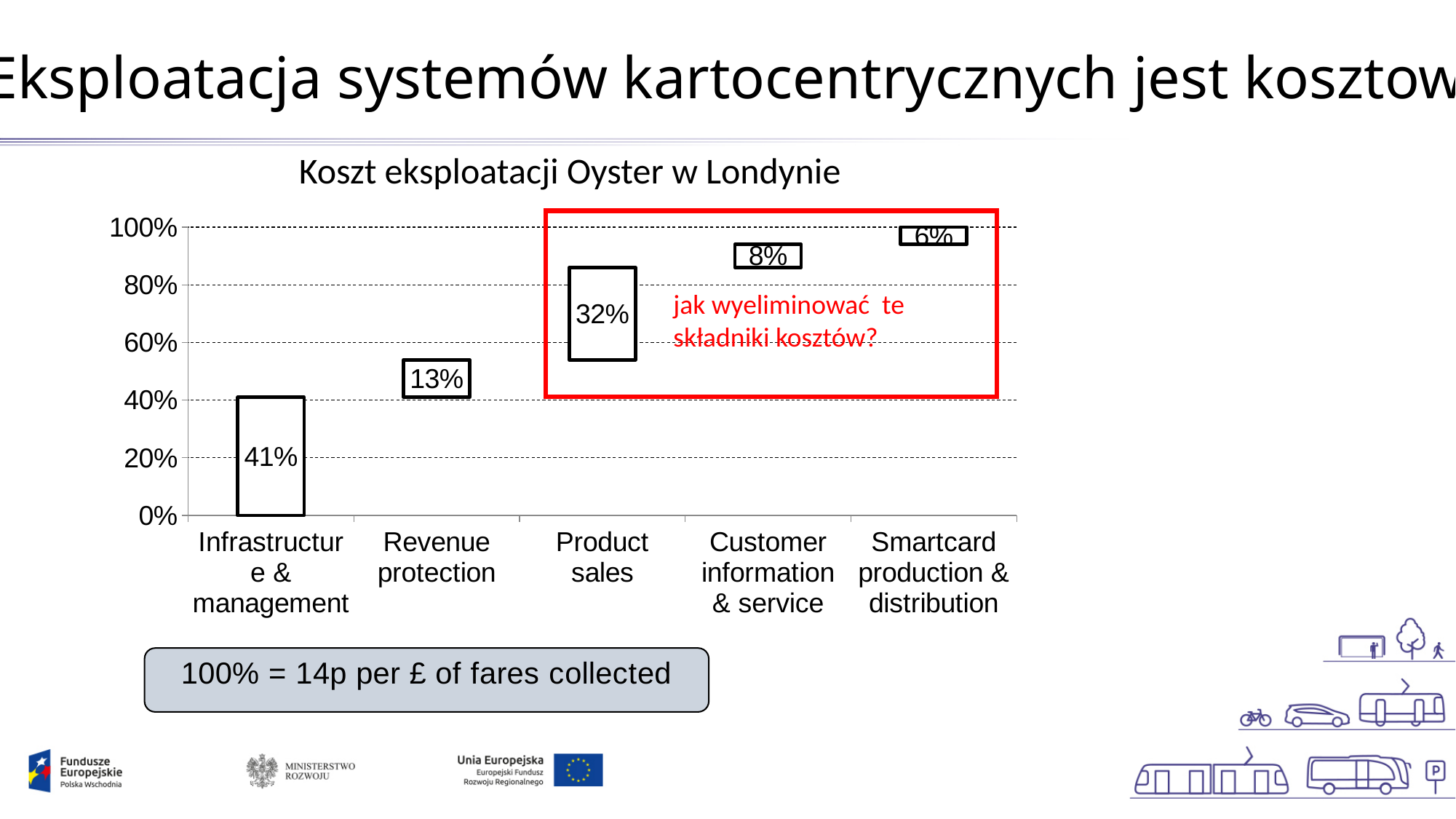
Which category has the highest value? Infrastructure & management What is the title of the chart? Koszt eksploatacji Oyster w Londynie Which category has the lowest value? Smartcard production & distribution What is the value for Infrastructure & management? 41% What is the sum of the values for Revenue protection and Customer information & service? 21% What is the value for Smartcard production & distribution? 6% How many categories are shown on the x axis? 5 What is the value for Customer information & service? 8% Which is larger, the value for Revenue protection or the value for Customer information & service? Revenue protection What kind of chart is shown on the slide? Bar chart What is the value for Product sales? 32% What is the difference between the values for Infrastructure & management and Product sales? 9%